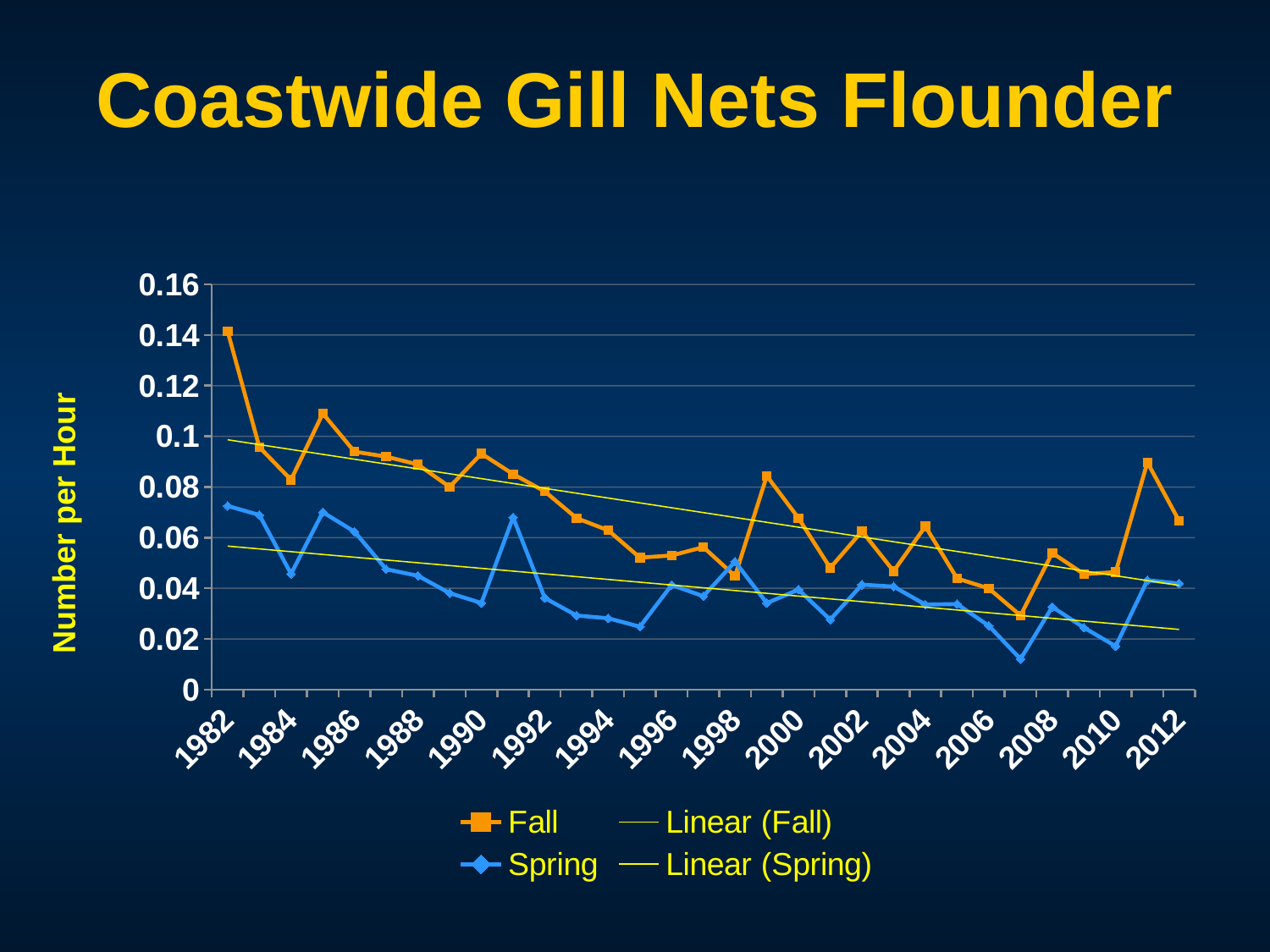
Is the Spring value for 1982 greater or less than 0.06? greater Is the Spring value for 2007 greater or less than 0.02? less What is the title of the chart? Coastwide Gill Nets Flounder In which year is the Spring series at its lowest value? 2007 How many entries does the legend list? 4 In 1982, which series has the larger value, Fall or Spring? Fall Is the Spring value for 1995 greater or less than 0.04? less What kind of chart is shown on the slide? line chart What is the label on the vertical axis? Number per Hour Overall, do the Fall values rise or fall from 1982 to 2012? fall In which year is the Fall series at its highest value? 1982